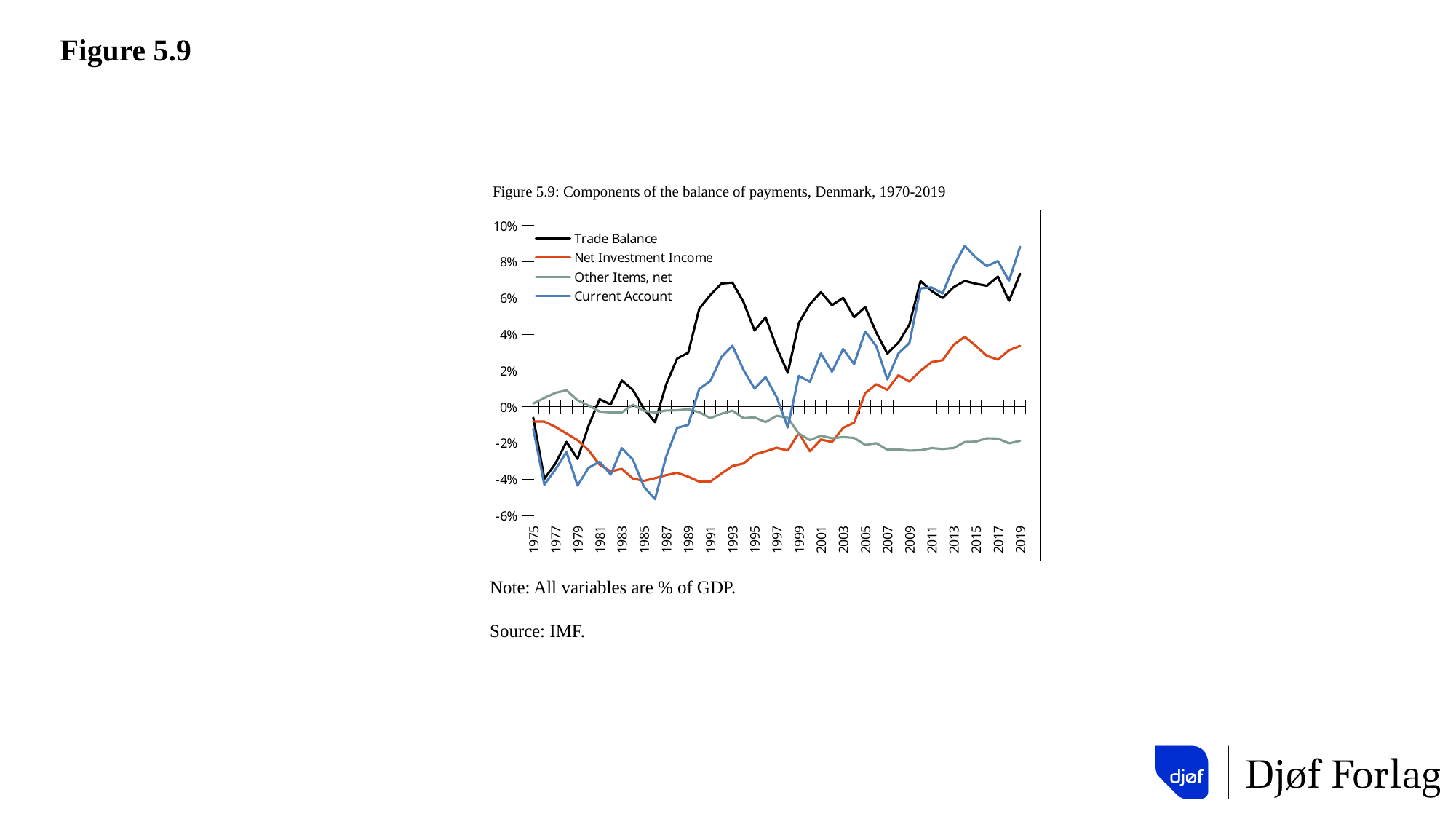
Is the value for Trade Balance in 1993 greater or less than 6%? greater Is the value for Net Investment Income in 1985 greater or less than -2%? less How many series does the legend list? 4 What kind of chart is shown on the slide? line chart In 1993, which is higher: Trade Balance or Current Account? Trade Balance Is the value for Other Items, net in 2019 greater or less than 0%? less What is the title of the chart? Figure 5.9: Components of the balance of payments, Denmark, 1970-2019 Does Net Investment Income rise or fall overall from 1985 to 2019? rise Which series has the lowest value in 1986? Current Account Which series is drawn as the black line? Trade Balance In 2019, which is higher: Current Account or Trade Balance? Current Account